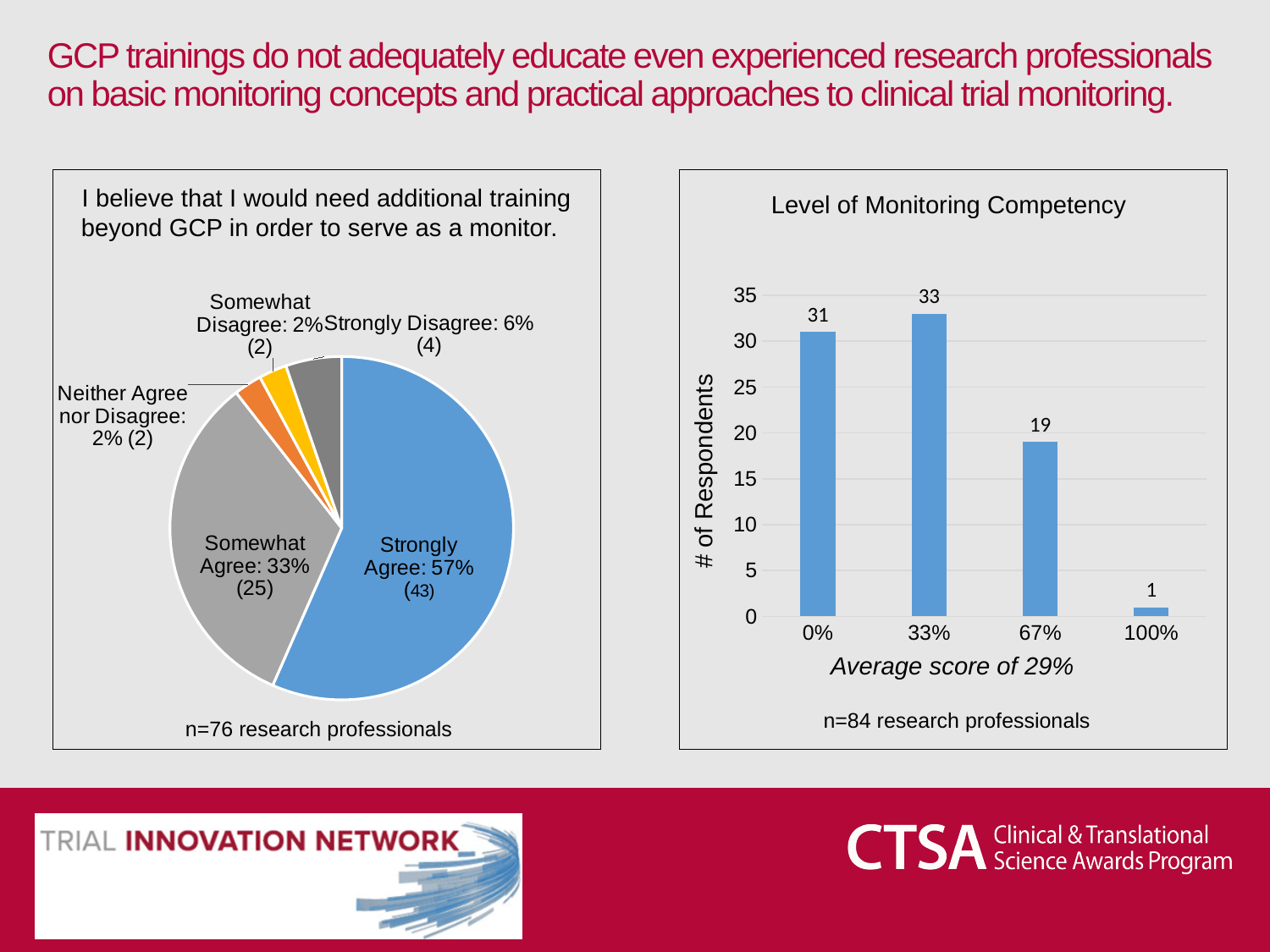
In the 'Level of Monitoring Competency' chart, how many respondents scored 100%? 1 In the 'Level of Monitoring Competency' chart, which score category has the fewest respondents? 100% In the 'Level of Monitoring Competency' chart, which score category has the most respondents? 33% In the pie chart on the left, how many respondents chose 'Somewhat Agree'? 25 In the pie chart on the left, what percentage of respondents chose 'Strongly Agree'? 57% In the pie chart on the left, which response has the largest share? Strongly Agree In the pie chart on the left, which is larger: the share for 'Strongly Disagree' or 'Somewhat Disagree'? Strongly Disagree In the 'Level of Monitoring Competency' chart, what is the difference in respondents between the 0% and 67% score categories? 12 In the 'Level of Monitoring Competency' chart, how many respondents scored 33%? 33 In the 'Level of Monitoring Competency' chart, how many score categories are shown on the x axis? 4 What kind of chart is the 'Level of Monitoring Competency' chart? Bar chart What average score is stated below the 'Level of Monitoring Competency' chart? 29%